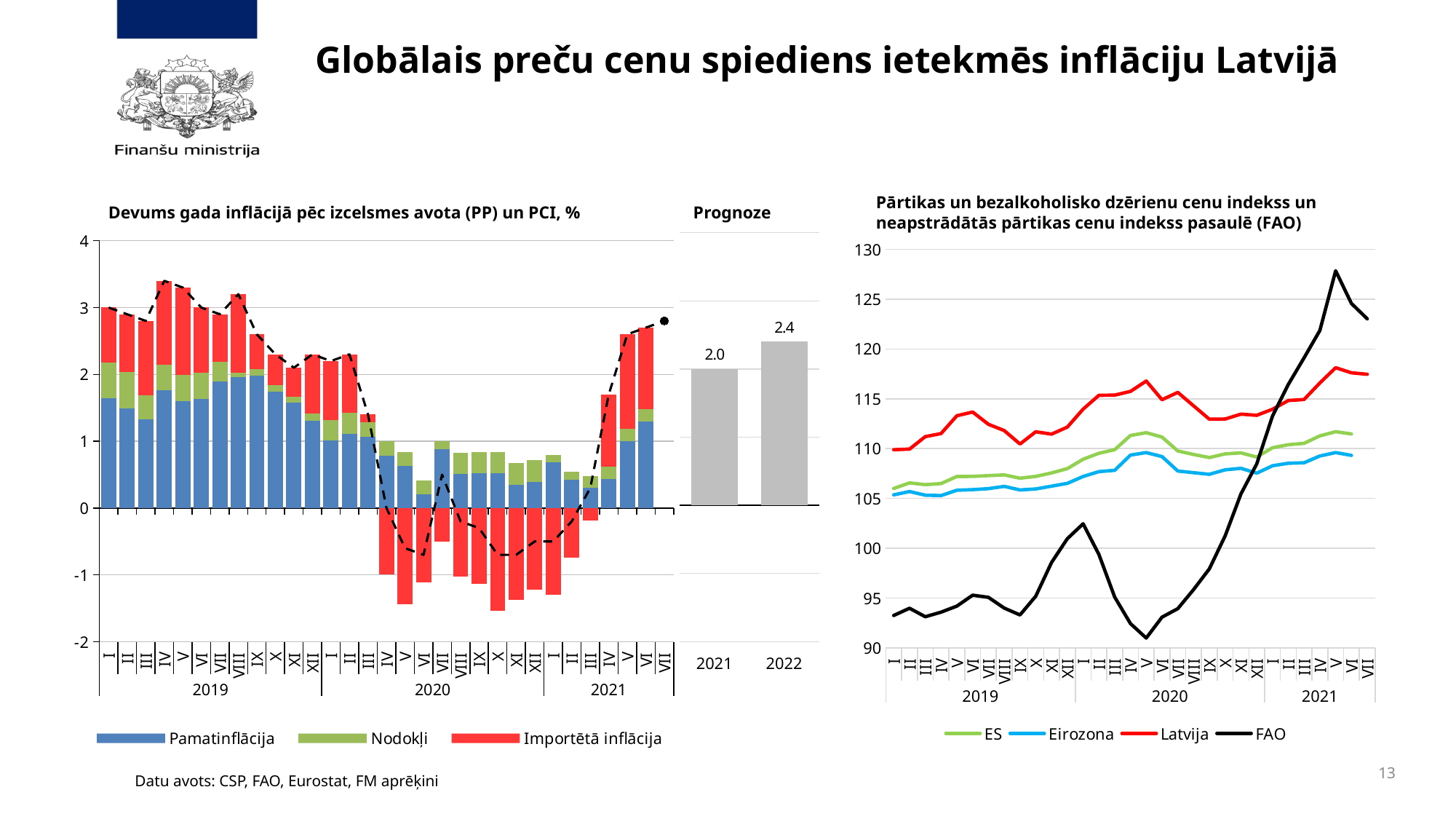
How many series does the legend of the left chart (Devums gada inflācijā) list? 3 In the right chart, which series has the highest value at VII 2021? FAO In the right chart, is the value for FAO in V 2020 greater or less than 95? less In the Prognoze panel of the left chart, which year has the larger forecast value, 2021 or 2022? 2022 What kind of chart is the left chart (Devums gada inflācijā pēc izcelsmes avota)? stacked bar chart with a line (combination bar and line chart) How many series does the legend of the right chart (Pārtikas un bezalkoholisko dzērienu cenu indekss) list? 4 In the Prognoze panel of the left chart, what is the forecast value for 2021? 2.0 What kind of chart is the right chart (Pārtikas un bezalkoholisko dzērienu cenu indekss)? line chart In the Prognoze panel of the left chart, what is the forecast value for 2022? 2.4 In the Prognoze panel of the left chart, what is the difference between the 2022 and 2021 forecast values? 0.4 In the right chart, is the value for FAO in V 2021 greater or less than 125? greater In the left chart, which colour represents Importētā inflācija? red